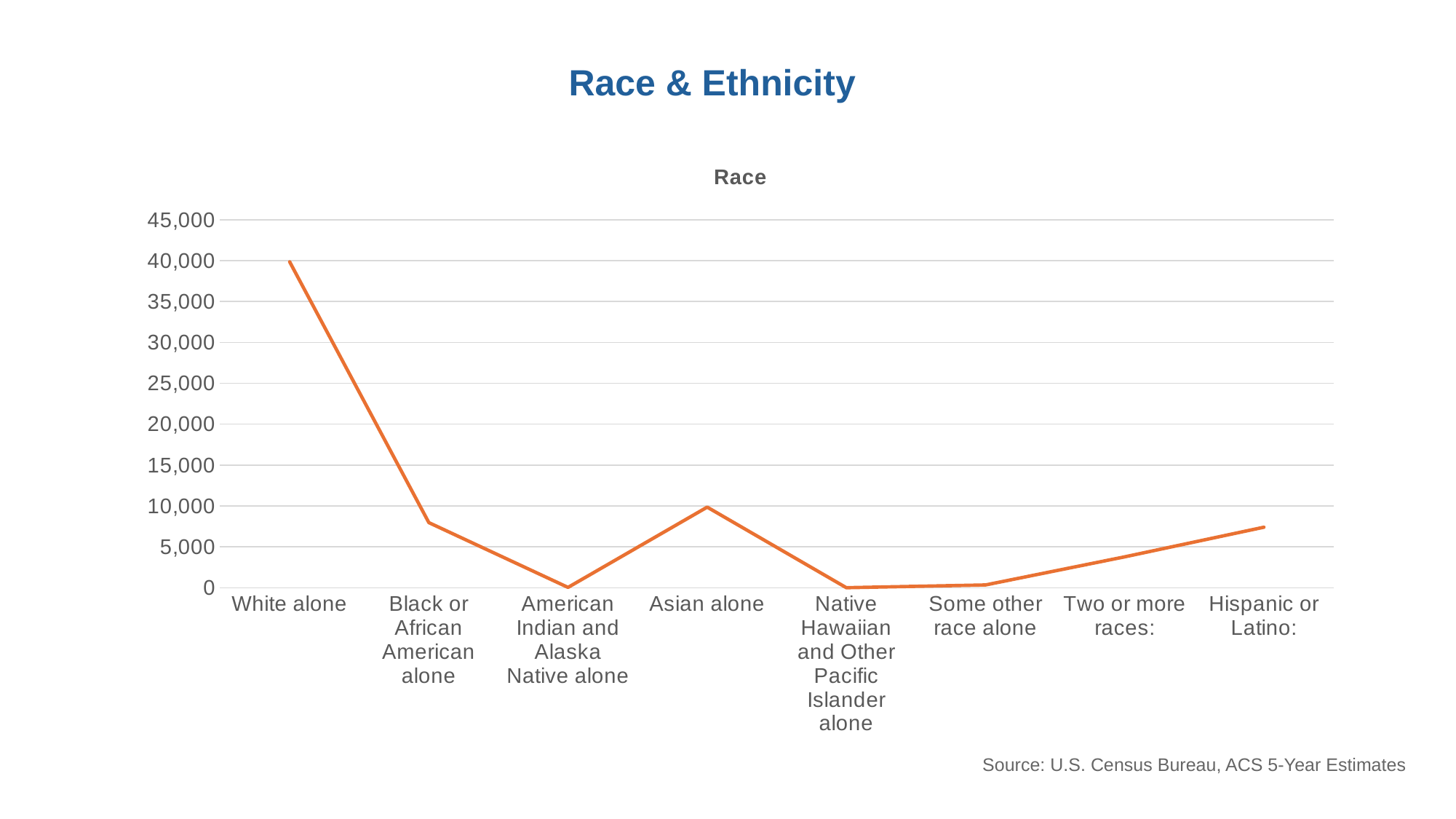
Is the value for Hispanic or Latino: greater or less than 5,000? greater Which is larger, the value for Asian alone or the value for Black or African American alone? Asian alone What is the title printed directly above the chart's plot area? Race Is the value for Two or more races: greater or less than 5,000? less How many categories are plotted along the x axis? 8 Does the line rise or fall from White alone to Black or African American alone? fall Is the value for White alone greater or less than 35,000? greater Which is larger, the value for Hispanic or Latino: or the value for Two or more races:? Hispanic or Latino: What kind of chart is shown on the slide? line chart Which category has the highest value? White alone